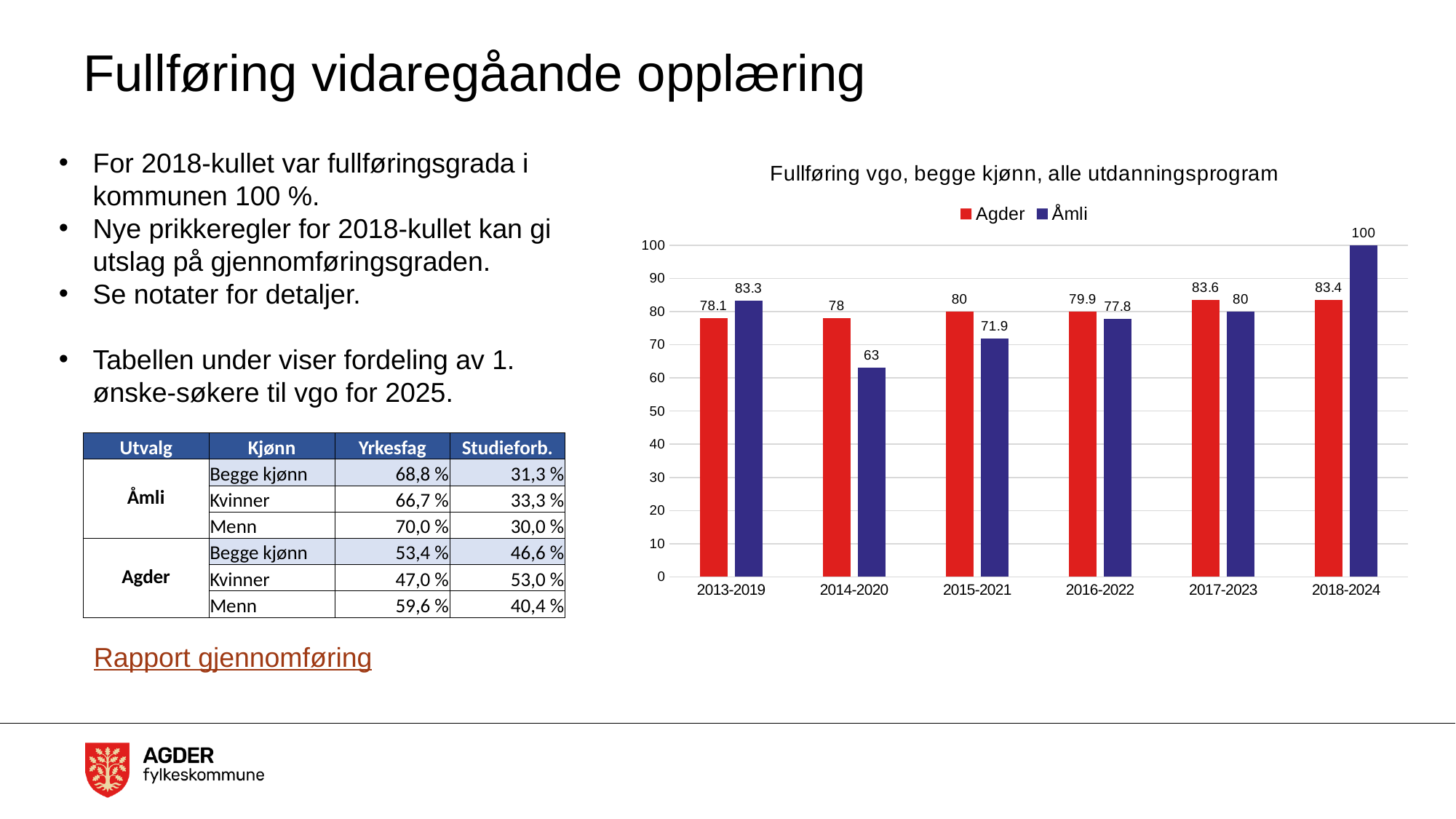
Which period has the highest value for Åmli? 2018-2024 Which period has the lowest value for Åmli? 2014-2020 Which is larger in 2015-2021, Agder or Åmli? Agder What is the value for Åmli in 2018-2024? 100 What is the difference between Agder and Åmli in 2014-2020? 15 How many periods are shown on the x axis? 6 What is the difference between Åmli and Agder in 2018-2024? 16.6 Which period has the lowest value for Agder? 2014-2020 How many series does the legend list? 2 What kind of chart is shown on the slide? Bar chart What is the value for Agder in 2017-2023? 83.6 What is the value for Åmli in 2014-2020? 63